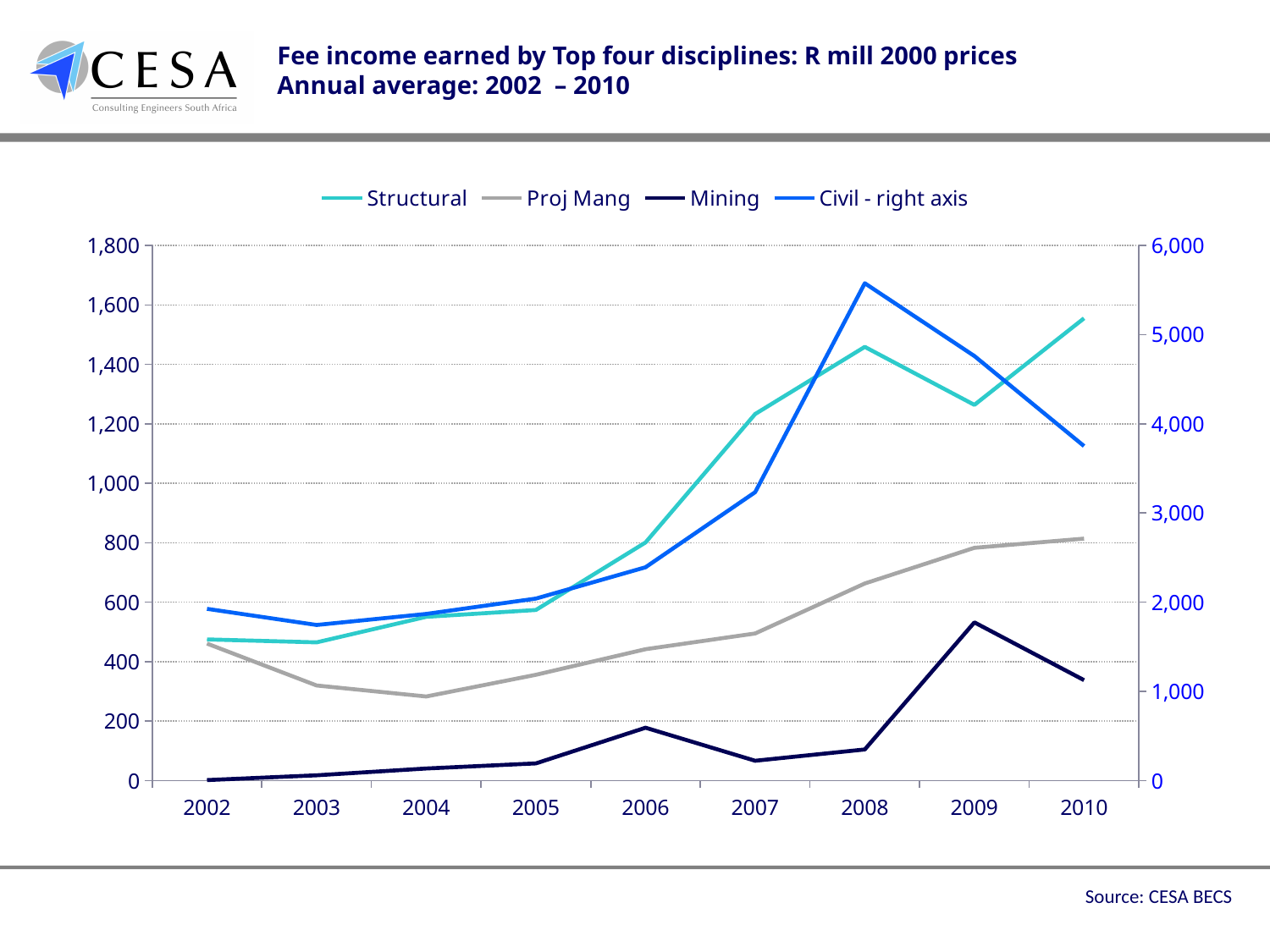
In which year is the Proj Mang series at its lowest? 2004 In 2010, which is larger: the Structural value or the Proj Mang value? Structural Is the Civil value for 2008 greater or less than 5,000 on the right axis? greater Is the Mining value for 2009 greater or less than 400? greater In which year does the Civil series reach its highest value? 2008 Which series is plotted against the right axis? Civil Is the Structural value for 2008 greater or less than 1,400? greater In which year does the Mining series peak? 2009 How many series does the legend list? 4 In which year does the Structural series reach its highest value? 2010 How many years are shown along the x axis? 9 What type of chart is shown on the slide? line chart